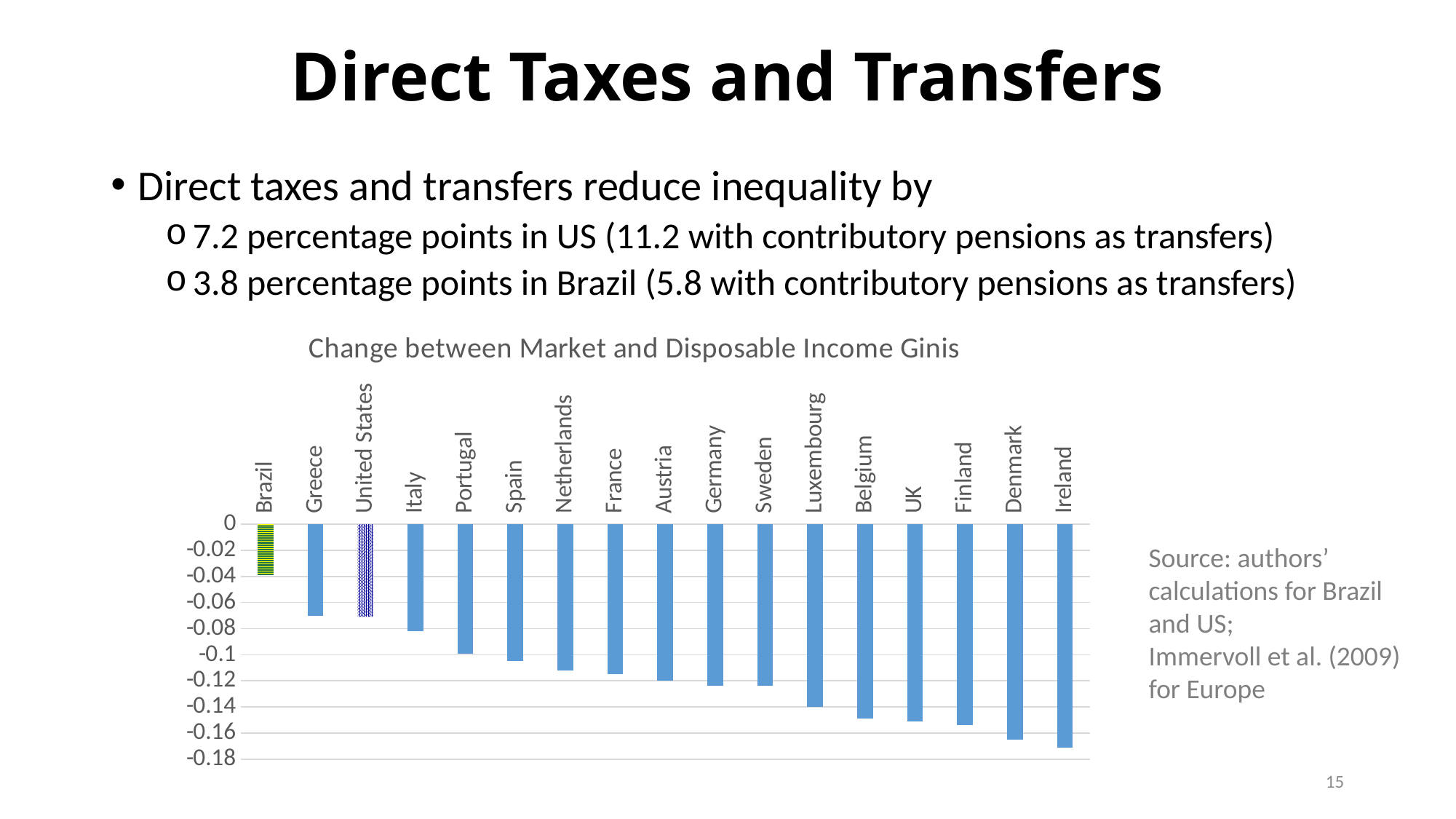
Which country has the longest bar (the most negative change) in the chart? Ireland Is the value for Italy greater or less than -0.1? greater Is the value for Ireland greater or less than -0.16? less How many countries are shown in the chart? 17 Which country has the shortest bar (the smallest change) in the chart? Brazil Do the values rise or fall moving from left to right along the x axis? fall Is the value for Brazil greater or less than -0.06? greater What kind of chart is shown on the slide? bar chart What is the title of the chart? Change between Market and Disposable Income Ginis Which has the larger (more negative) change, Ireland or Greece? Ireland